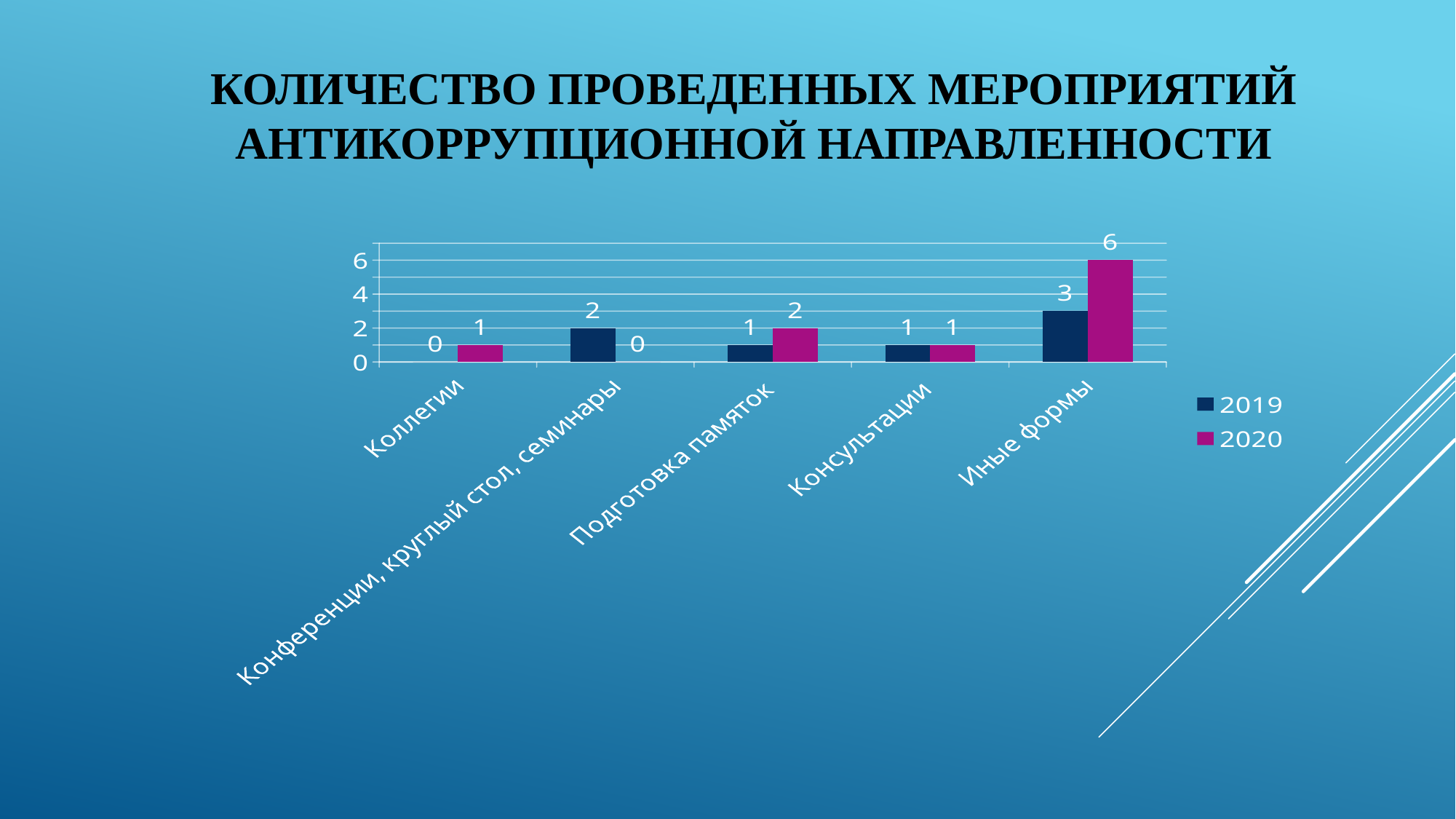
What kind of chart is shown on the slide? Bar chart How many series does the legend list? 2 Which series is shown in magenta in the legend? 2020 Which category has the lowest value for 2019? Коллегии Which category has the highest value for 2020? Иные формы What is the difference between the 2020 and 2019 values for Иные формы? 3 What is the value for 2020 in the Коллегии category? 1 What is the value for 2020 in the Иные формы category? 6 What is the value for 2019 in the Подготовка памяток category? 1 Which is larger for Конференции, круглый стол, семинары: the 2019 value or the 2020 value? 2019 What is the value for 2019 in the Конференции, круглый стол, семинары category? 2 How many categories are shown on the x axis? 5